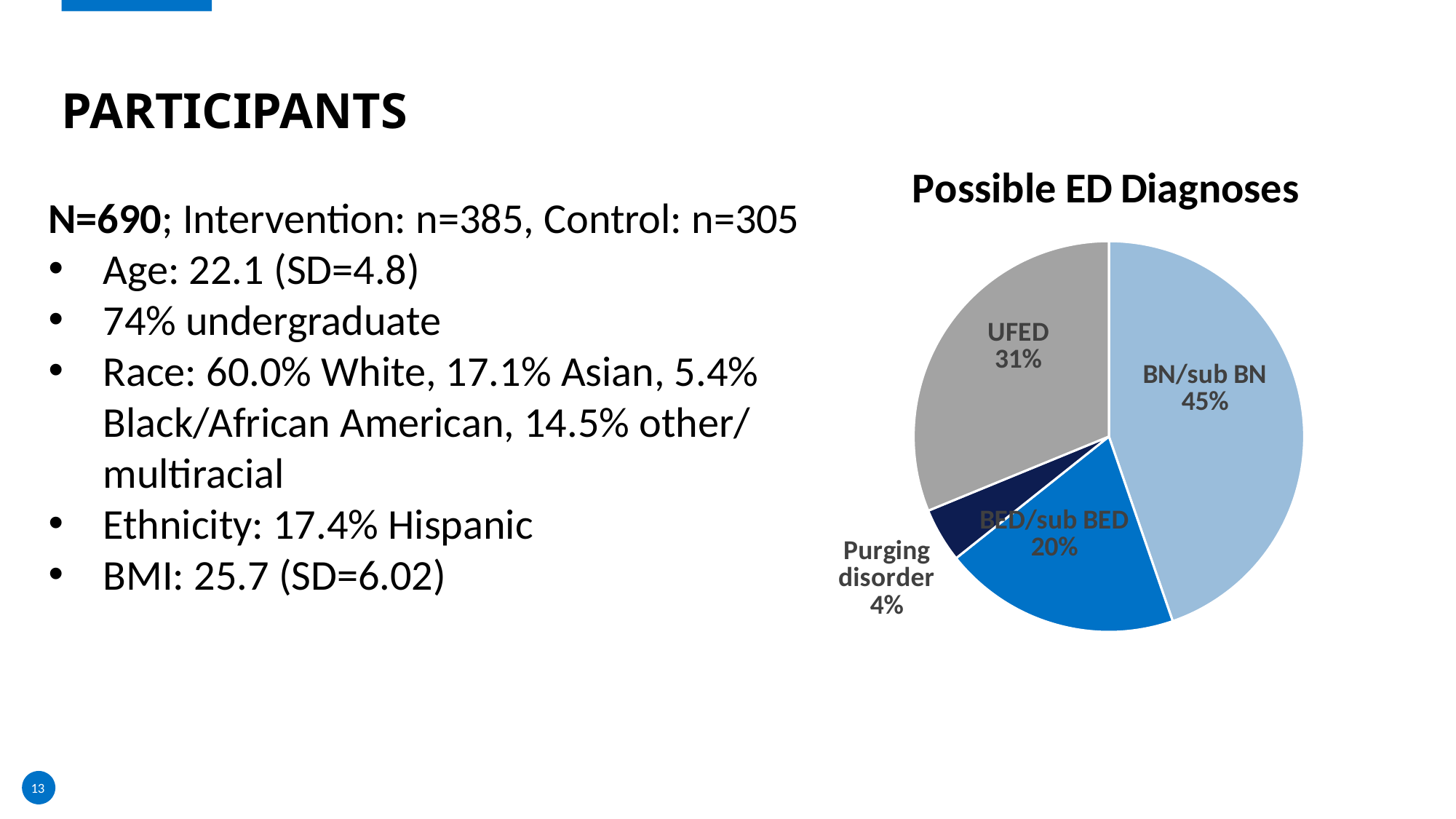
Which diagnosis category has the largest share of the pie? BN/sub BN What percentage of the pie is BED/sub BED? 20% What type of chart is shown on the slide? pie chart What percentage of the pie is BN/sub BN? 45% What is the title of the chart? Possible ED Diagnoses Which diagnosis category has the smallest share of the pie? Purging disorder What is the difference in percentage points between BED/sub BED and Purging disorder? 16 What percentage of the pie is UFED? 31% What percentage of the pie is Purging disorder? 4% How many slices does the pie chart have? 4 What is the difference in percentage points between BN/sub BN and UFED? 14 Which is larger, the share for UFED or the share for BED/sub BED? UFED